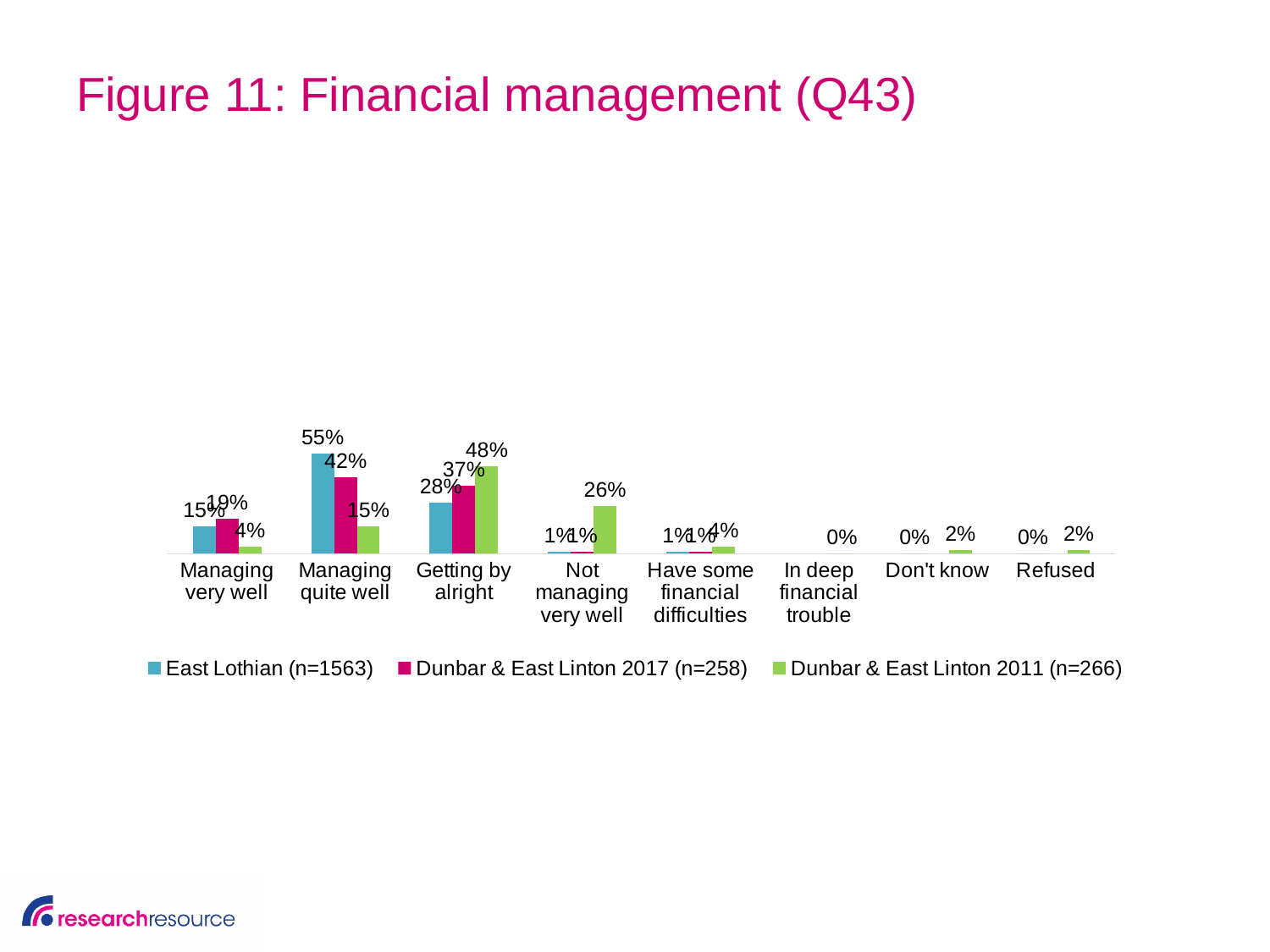
What is the value for Dunbar & East Linton 2011 (n=266) in the 'Getting by alright' category? 48% What is the value for Dunbar & East Linton 2017 (n=258) in the 'Getting by alright' category? 37% Which category has the highest value for East Lothian (n=1563)? Managing quite well What is the value for Dunbar & East Linton 2011 (n=266) in the 'Not managing very well' category? 26% Which series has the highest value in the 'Getting by alright' category? Dunbar & East Linton 2011 (n=266) In the 'Managing very well' category, which is larger: East Lothian (n=1563) or Dunbar & East Linton 2011 (n=266)? East Lothian (n=1563) What kind of chart is shown on the slide? Bar chart What is the value for Dunbar & East Linton 2011 (n=266) in the 'Managing quite well' category? 15% How many categories are shown on the x axis of the chart? 8 What is the difference between East Lothian (n=1563) and Dunbar & East Linton 2017 (n=258) in the 'Managing quite well' category? 13 percentage points How many series does the legend list? 3 What is the value for East Lothian (n=1563) in the 'Managing quite well' category? 55%